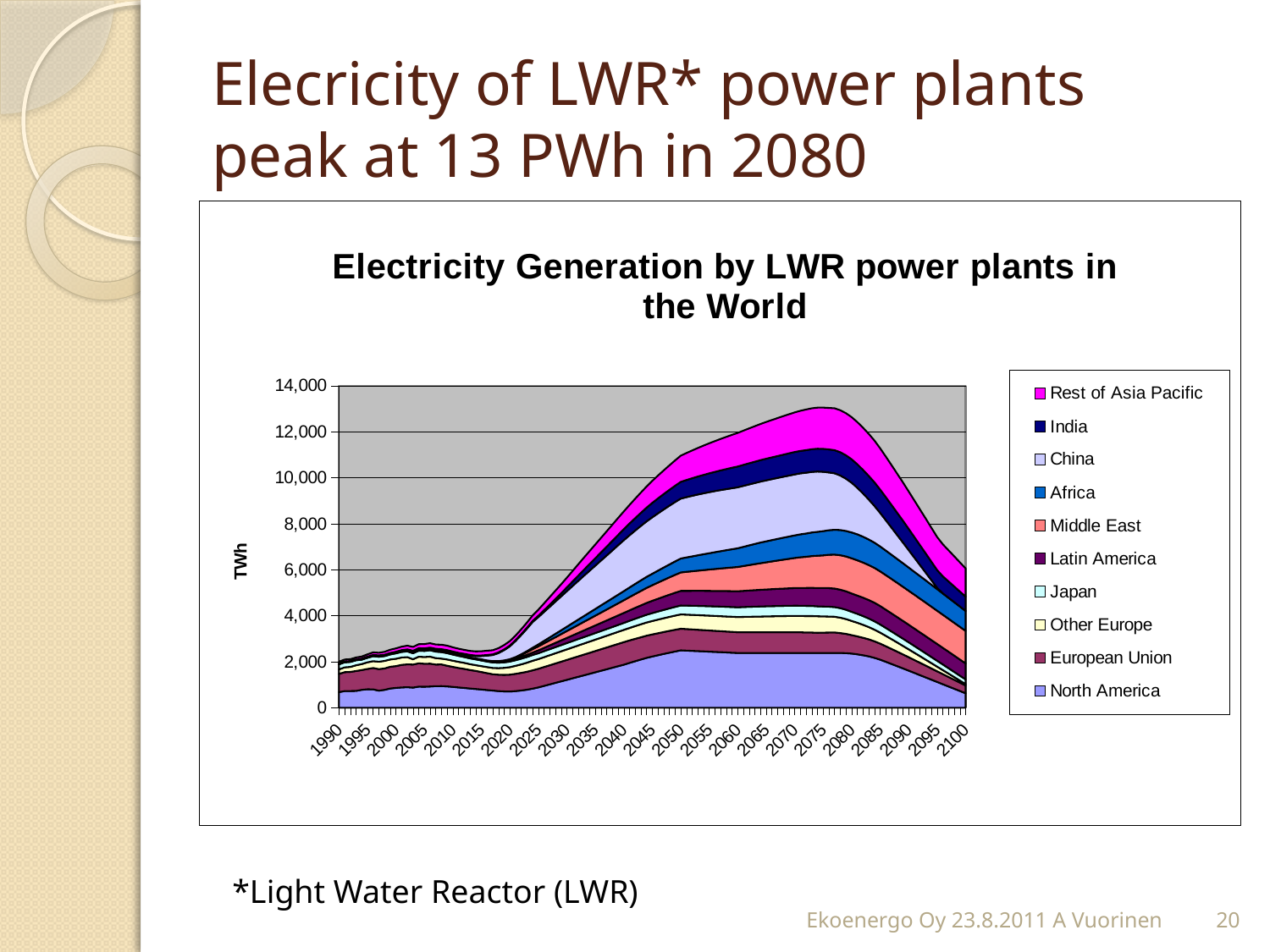
What is the title of the chart? Electricity Generation by LWR power plants in the World Is the total electricity generation in 2020 greater or less than 4,000 TWh? less How many series does the legend list? 10 What unit is shown on the vertical axis label? TWh Is the total electricity generation in 2075 greater or less than 12,000 TWh? greater Is the total electricity generation in 2050 greater or less than 10,000 TWh? greater Which series is plotted at the bottom of the stack? North America How many year labels are shown along the x axis? 23 What kind of chart is shown on the slide? Stacked area chart Does the total electricity generation rise or fall between 2020 and 2050? rise Does the total electricity generation rise or fall between 2080 and 2100? fall